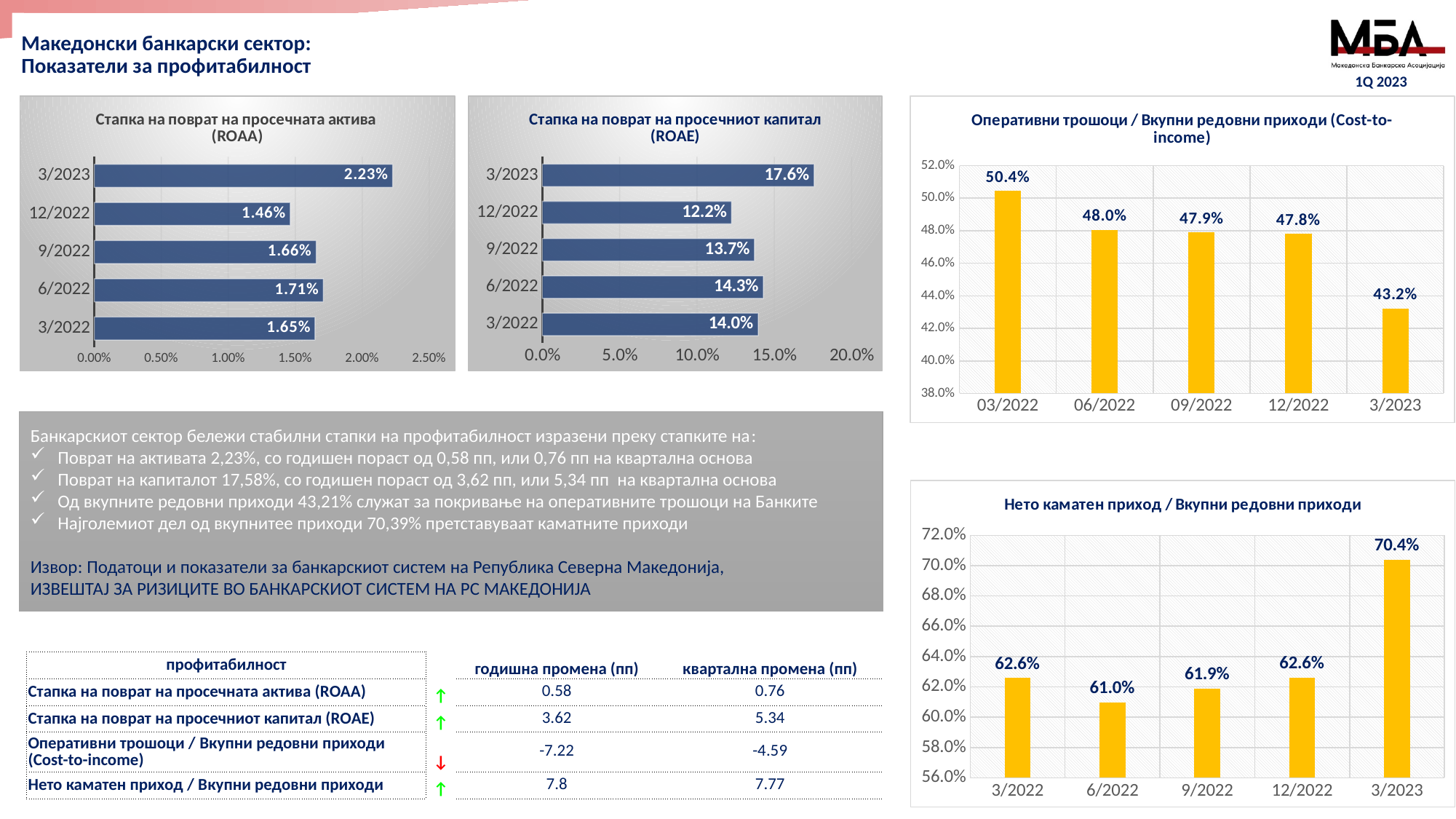
How many periods are shown in the Нето каматен приход / Вкупни редовни приходи chart? 5 In the ROAE chart, which period has the highest value? 3/2023 In the ROAE chart (Стапка на поврат на просечниот капитал), what is the value for 6/2022? 14.3% In the ROAE chart, what is the difference between the 3/2023 value and the 12/2022 value? 5.4 percentage points In the Cost-to-income chart, which period has the lowest value? 3/2023 In the ROAA chart, which period has the lowest value? 12/2022 In the ROAA chart (Стапка на поврат на просечната актива), what is the value for 3/2023? 2.23% In the Cost-to-income chart, do the values generally rise or fall from 03/2022 to 3/2023? fall In the Cost-to-income chart (Оперативни трошоци / Вкупни редовни приходи), what is the value for 03/2022? 50.4% In the Нето каматен приход / Вкупни редовни приходи chart, which is larger: the value for 6/2022 or the value for 9/2022? 9/2022 In the Нето каматен приход / Вкупни редовни приходи chart, what is the value for 3/2023? 70.4% What type of chart is the ROAA chart? bar chart